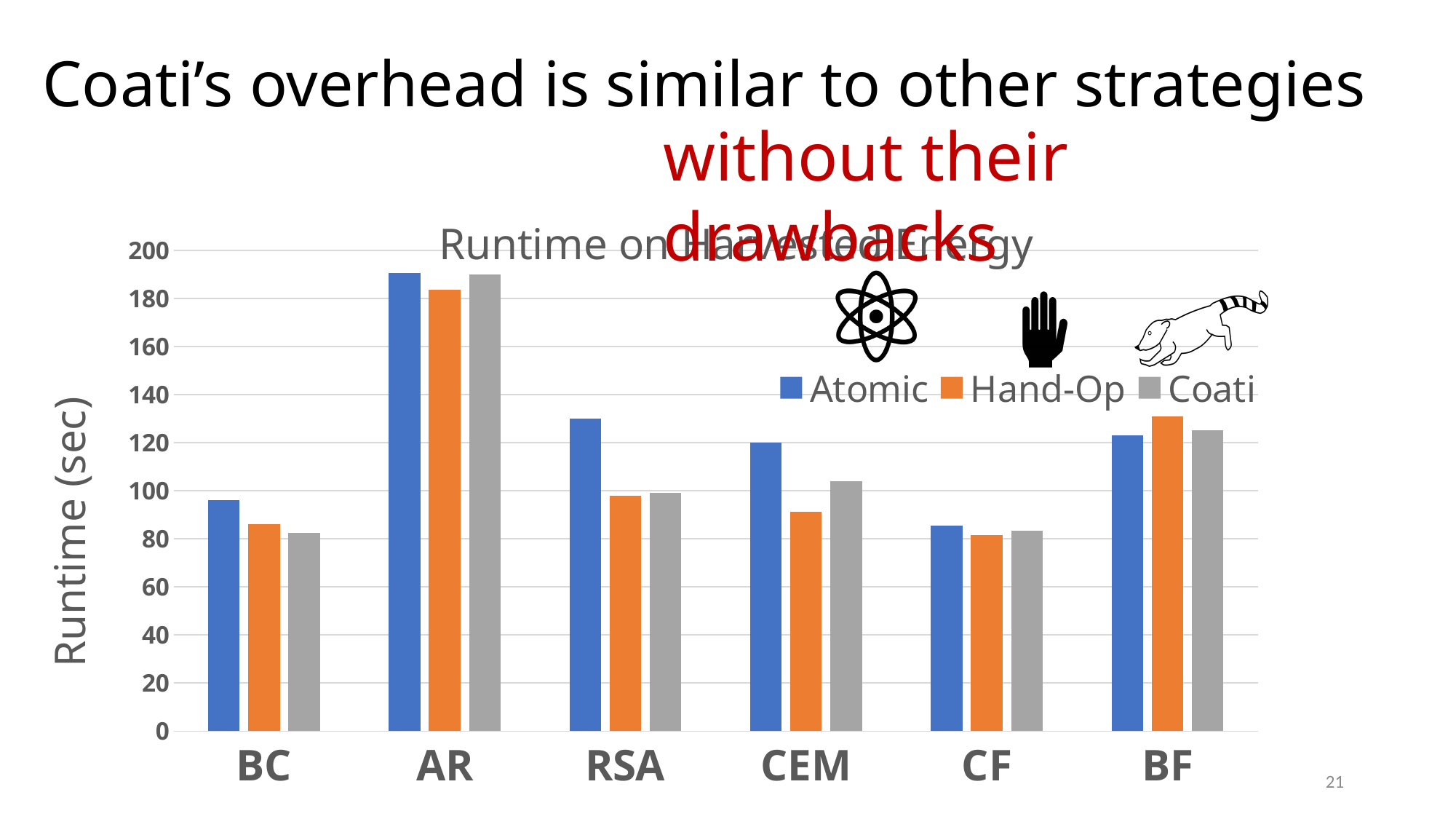
How many categories are shown on the x axis of the chart? 6 Which category has the lowest Atomic runtime? CF For CEM, which is larger: the Coati value or the Hand-Op value? Coati How many series does the chart's legend list? 3 What kind of chart is shown on the slide? bar chart Is the Atomic value for BC greater or less than 100? less Is the Atomic value for AR greater or less than 180? greater Which category has the highest runtime across all series? AR Which series are listed in the chart's legend? Atomic, Hand-Op, Coati What is the label on the chart's y axis? Runtime (sec) For RSA, which is larger: the Atomic value or the Hand-Op value? Atomic Is the Hand-Op value for BF greater or less than 120? greater